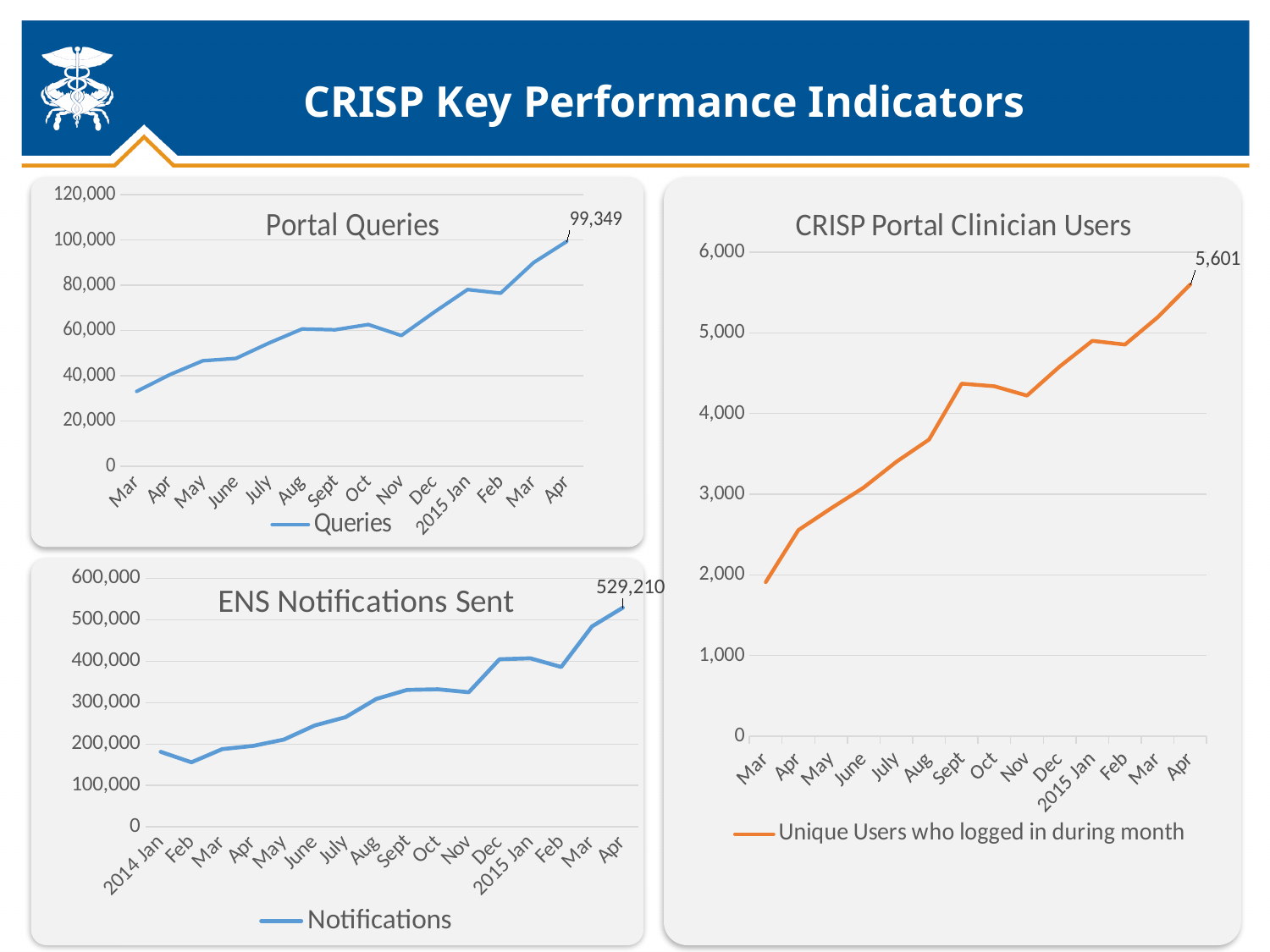
On the Portal Queries chart, what is the value for Apr (the last point)? 99,349 On the Portal Queries chart, which month has the highest value? Apr On the CRISP Portal Clinician Users chart, is the value for Sept greater or less than 4,000? greater On the ENS Notifications Sent chart, what is the value for Apr (the last point)? 529,210 On the CRISP Portal Clinician Users chart, what is the value for Apr (the last point)? 5,601 On the CRISP Portal Clinician Users chart, do the values generally rise or fall from Mar to Apr? Rise On the CRISP Portal Clinician Users chart, which month has the lowest value? Mar What is the legend entry on the CRISP Portal Clinician Users chart? Unique Users who logged in during month On the ENS Notifications Sent chart, which month has the lowest value? Feb On the Portal Queries chart, is the value for Mar (the first point) greater or less than 40,000? less How many data points are plotted on the ENS Notifications Sent chart? 16 What kind of chart is the CRISP Portal Clinician Users chart? Line chart